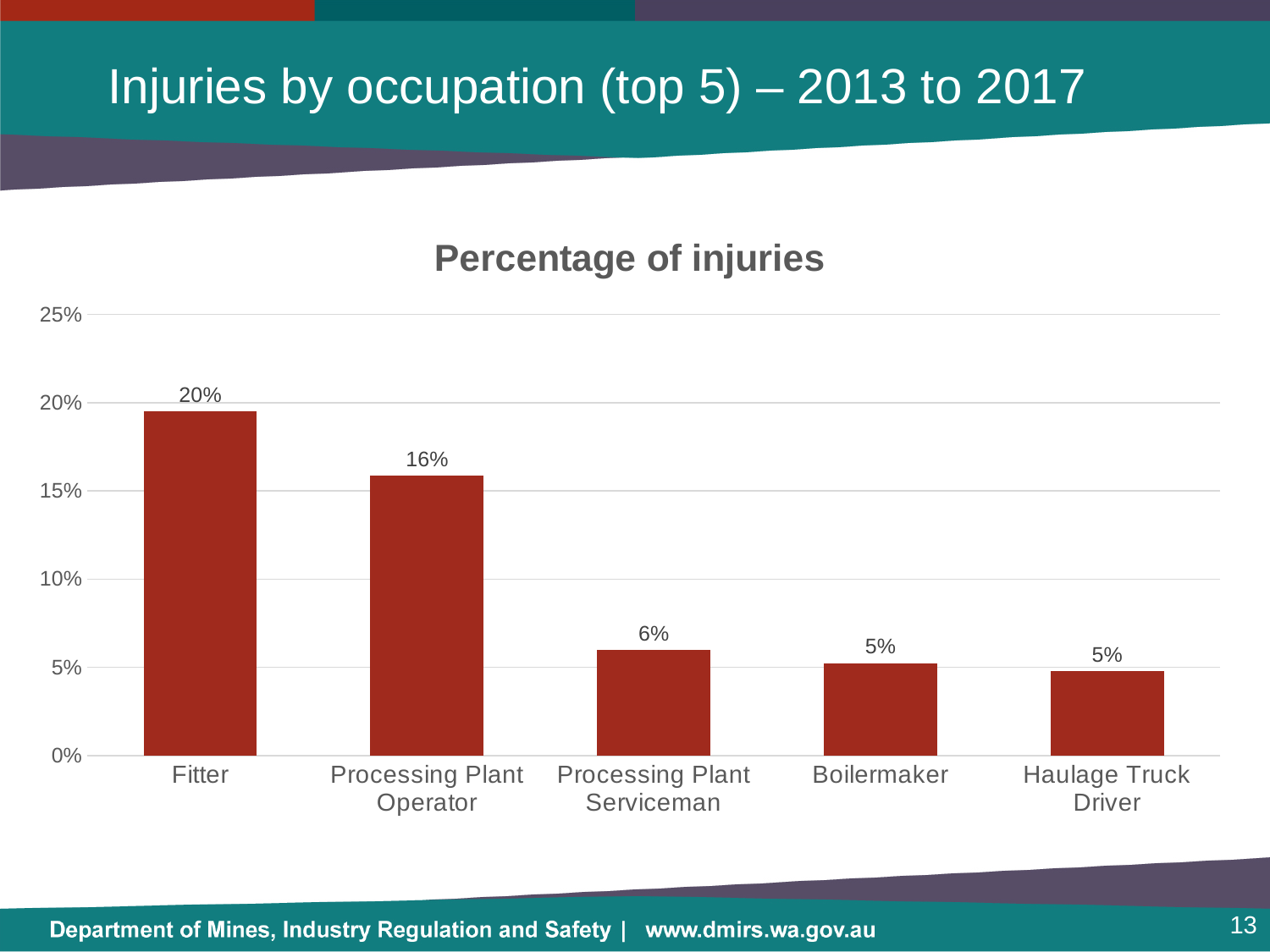
Which has a larger percentage of injuries, Processing Plant Operator or Processing Plant Serviceman? Processing Plant Operator What is the percentage of injuries for Processing Plant Operator? 16% How many occupations are shown in the chart? 5 What is the percentage of injuries for Processing Plant Serviceman? 6% What is the title of the chart? Percentage of injuries What kind of chart is shown on the slide? Bar chart What is the percentage of injuries for Boilermaker? 5% Is the value for Fitter greater or less than 15%? greater What is the difference in percentage of injuries between Fitter and Processing Plant Operator? 4% What is the percentage of injuries for Fitter? 20% Which occupation has the highest percentage of injuries? Fitter Do the values rise or fall from left to right across the occupations? Fall